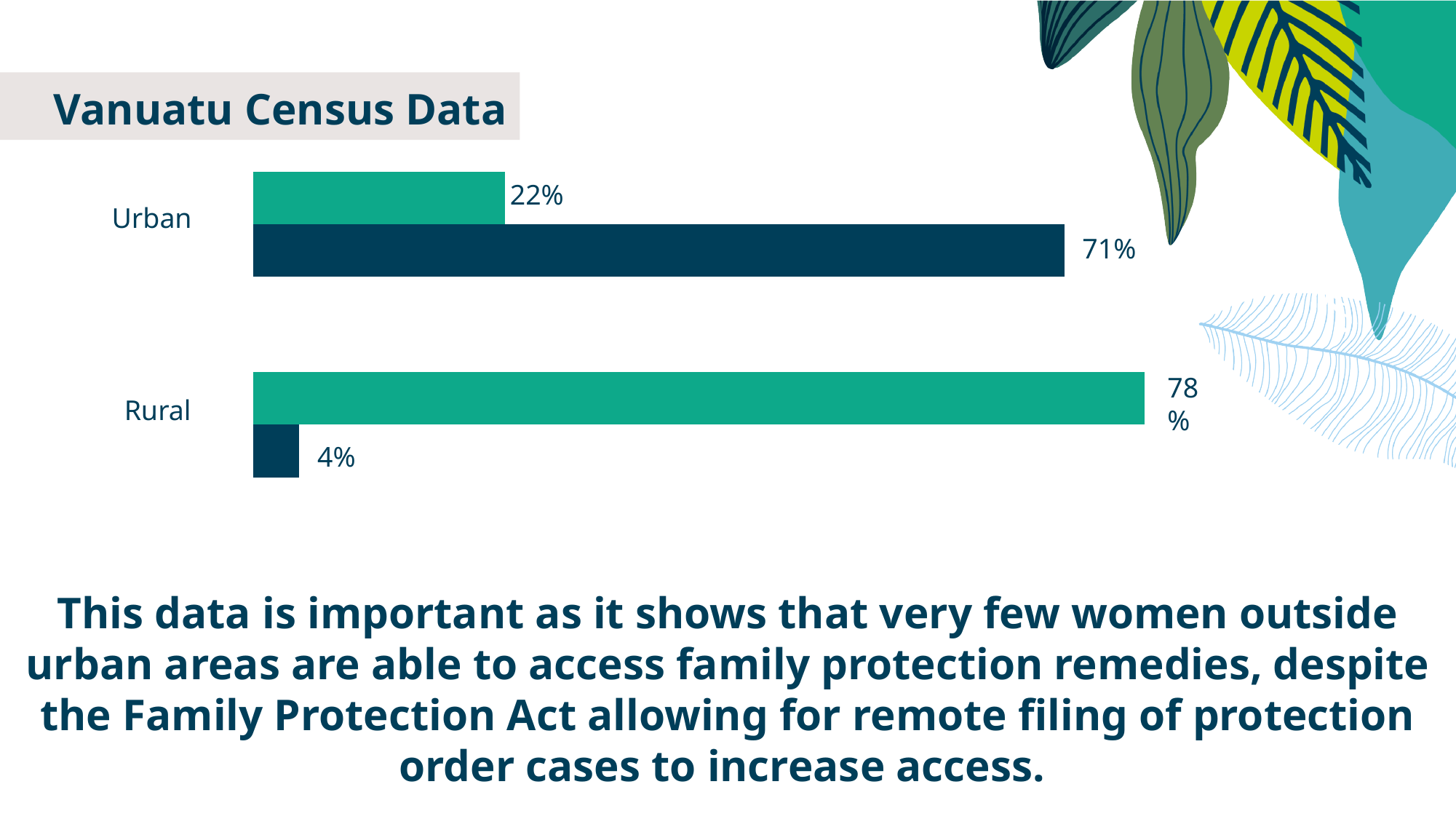
What type of chart is shown on the slide? bar chart What is the value of the dark blue bar for Urban? 71% What is the value of the dark blue bar for Rural? 4% What is the difference between the green bar values for Rural and Urban? 56% What is the title shown above the chart? Vanuatu Census Data How many categories are shown on the chart? 2 What is the difference between the dark blue bar values for Urban and Rural? 67% Is the green bar for Rural larger or smaller than the dark blue bar for Rural? larger What is the value of the green bar for Rural? 78% Which category has the lower value for the green bars? Urban What is the value of the green bar for Urban? 22% Which category has the higher value for the dark blue bars? Urban